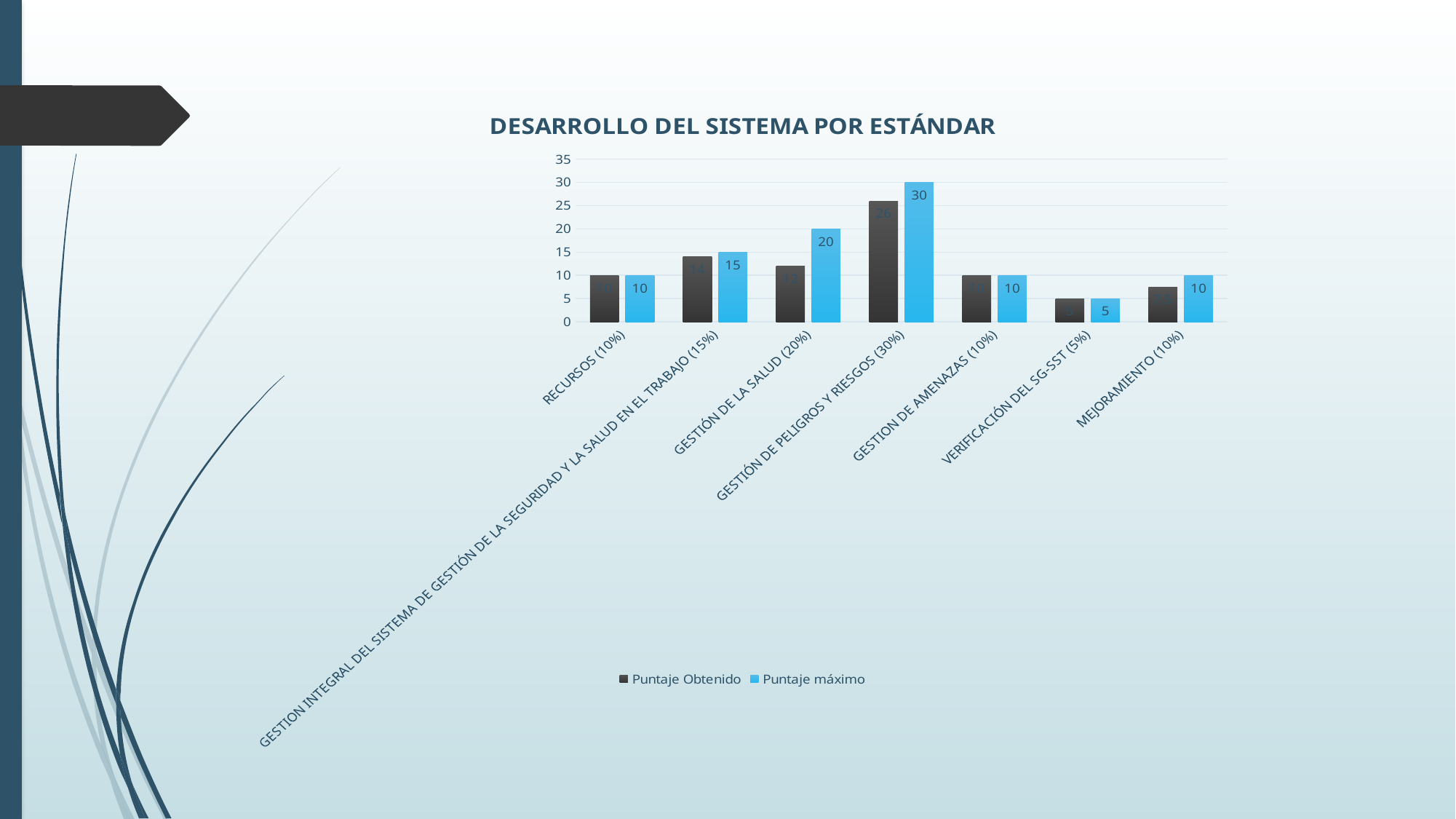
How many categories are shown on the x axis? 7 How many series does the legend list? 2 What is the Puntaje máximo value for GESTIÓN DE LA SALUD (20%)? 20 What is the Puntaje máximo value for GESTIÓN DE PELIGROS Y RIESGOS (30%)? 30 What is the difference between the Puntaje máximo for GESTIÓN DE PELIGROS Y RIESGOS (30%) and for GESTIÓN DE LA SALUD (20%)? 10 What kind of chart is shown on the slide? bar chart Which category has the lowest Puntaje máximo? VERIFICACIÓN DEL SG-SST (5%) Which is larger for MEJORAMIENTO (10%): Puntaje Obtenido or Puntaje máximo? Puntaje máximo What is the Puntaje máximo value for VERIFICACIÓN DEL SG-SST (5%)? 5 Which category has the highest Puntaje máximo? GESTIÓN DE PELIGROS Y RIESGOS (30%) Is the Puntaje Obtenido value for GESTIÓN DE PELIGROS Y RIESGOS (30%) greater or less than 20? greater What is the title of the chart? DESARROLLO DEL SISTEMA POR ESTÁNDAR